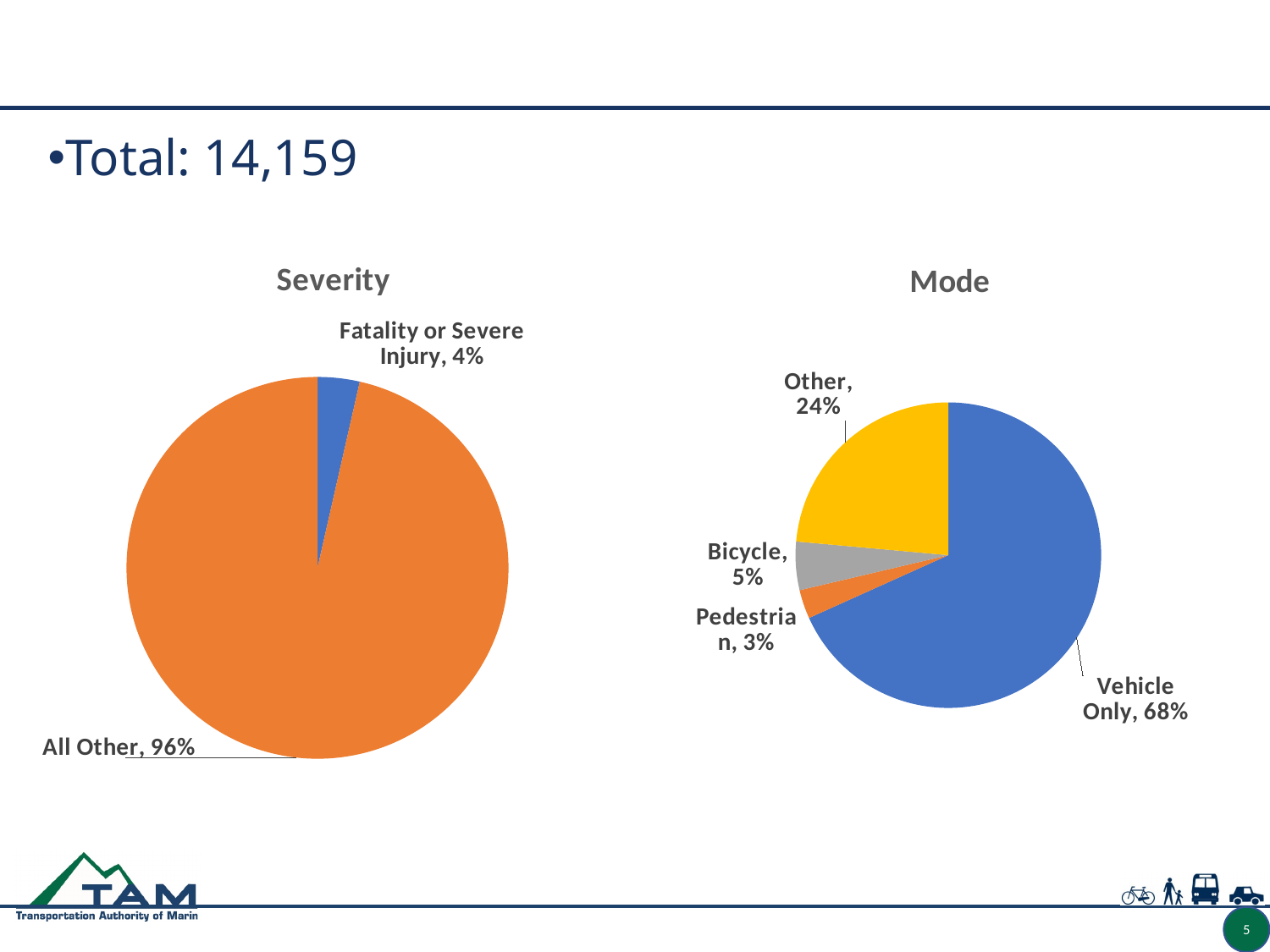
In the Mode chart, which category has the largest slice? Vehicle Only What kind of chart is the Severity chart? Pie chart In the Mode chart, what share is labelled for Bicycle? 5% In the Mode chart, what share is labelled for Other? 24% In the Mode chart, what share is labelled for Pedestrian? 3% How many slices does the Mode chart have? 4 In the Mode chart, what is the difference in percentage points between Vehicle Only and Other? 44 In the Mode chart, which category has the smallest slice? Pedestrian In the Mode chart, which is larger, Bicycle or Pedestrian? Bicycle